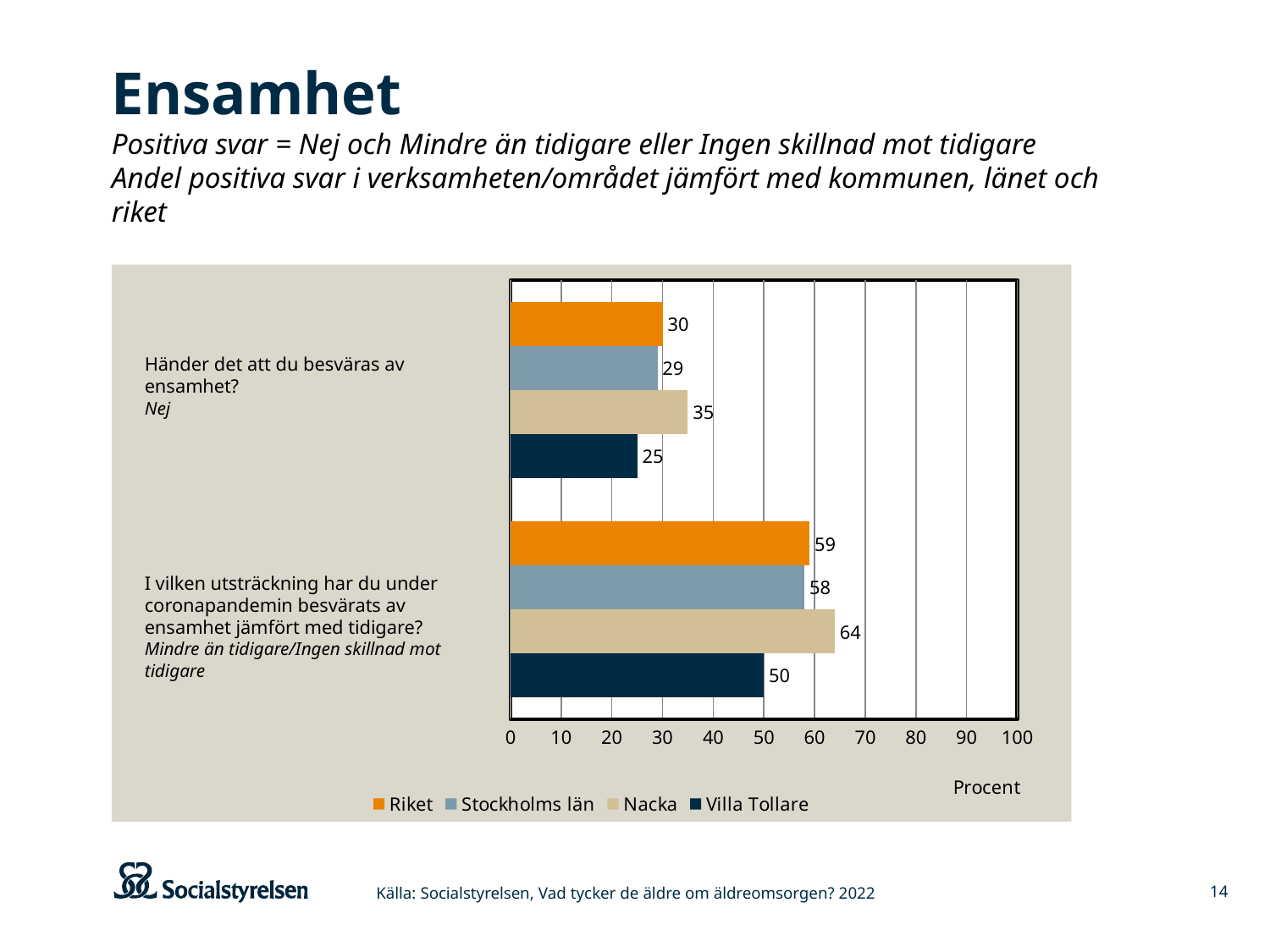
How many question categories are shown on the chart? 2 Which series has the highest value for the question 'I vilken utsträckning har du under coronapandemin besvärats av ensamhet jämfört med tidigare?'? Nacka What unit is shown on the x axis of the chart? Procent What is the value for Nacka for the question 'Händer det att du besväras av ensamhet?'? 35 Which series has the lowest value for the question 'Händer det att du besväras av ensamhet?'? Villa Tollare What is the value for Riket for the question 'Händer det att du besväras av ensamhet?'? 30 Which is larger for the question 'Händer det att du besväras av ensamhet?': the value for Nacka or the value for Villa Tollare? Nacka What kind of chart is shown on the slide? bar chart What is the difference between the Nacka and Villa Tollare values for the question 'I vilken utsträckning har du under coronapandemin besvärats av ensamhet jämfört med tidigare?'? 14 What is the value for Villa Tollare for the question 'I vilken utsträckning har du under coronapandemin besvärats av ensamhet jämfört med tidigare?'? 50 What is the value for Stockholms län for the question 'I vilken utsträckning har du under coronapandemin besvärats av ensamhet jämfört med tidigare?'? 58 How many series does the legend list? 4